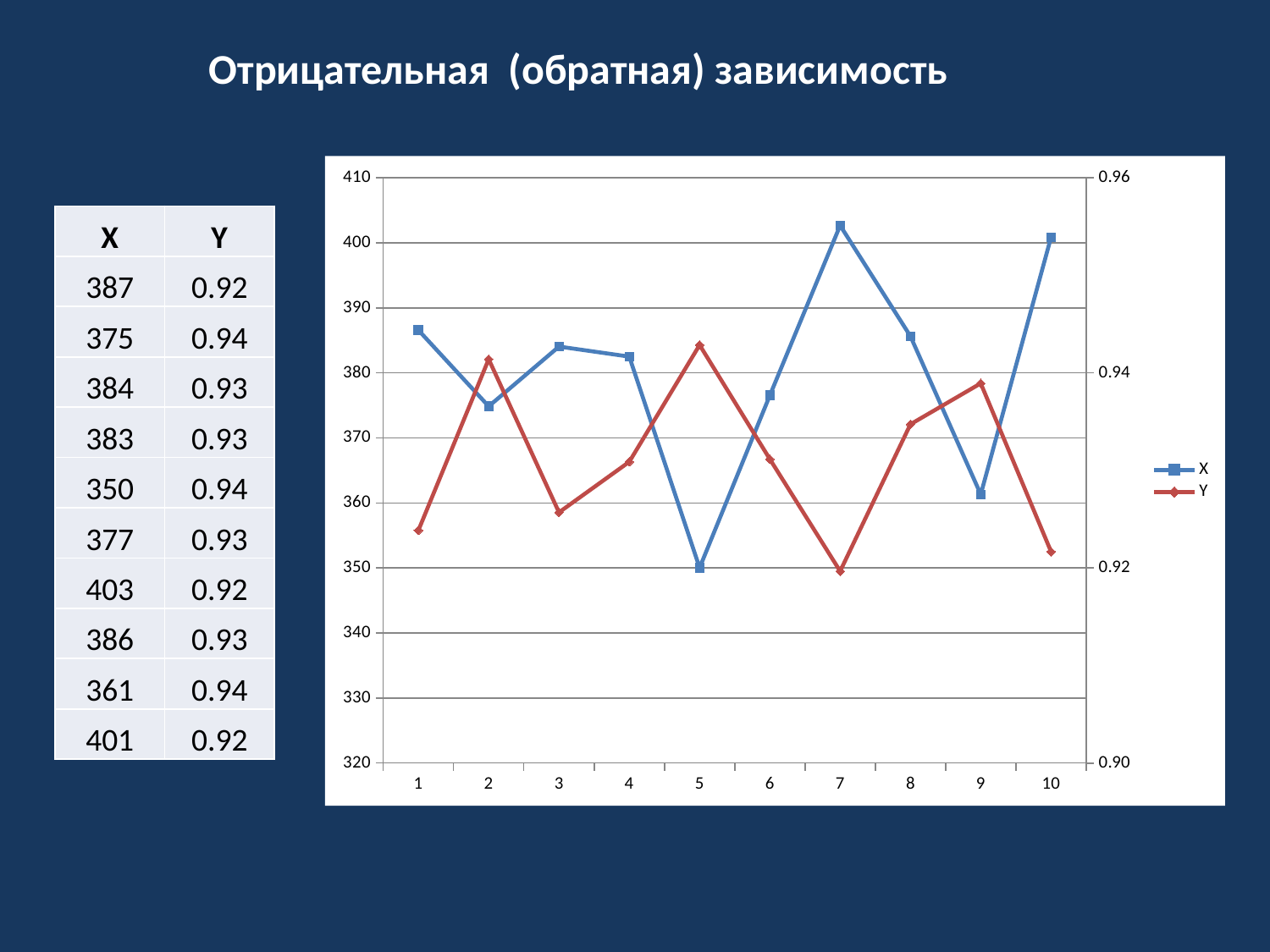
According to the table on the slide, what is the value of X in the fifth row? 350 Is the value of series X at point 7 greater or less than 400? greater What kind of chart is shown on the slide? line chart Is the value of series Y at point 4 greater or less than 0.94? less Which colour is used for series Y in the chart? red Does series X rise or fall from point 7 to point 9? fall How many points are plotted along the x axis for each series? 10 How many series does the chart legend list? 2 Which is larger, the value of series X at point 1 or at point 2? point 1 At which x-axis point does series X reach its highest value? 7 Is the value of series X at point 9 greater or less than 370? less At which x-axis point does series X reach its lowest value? 5